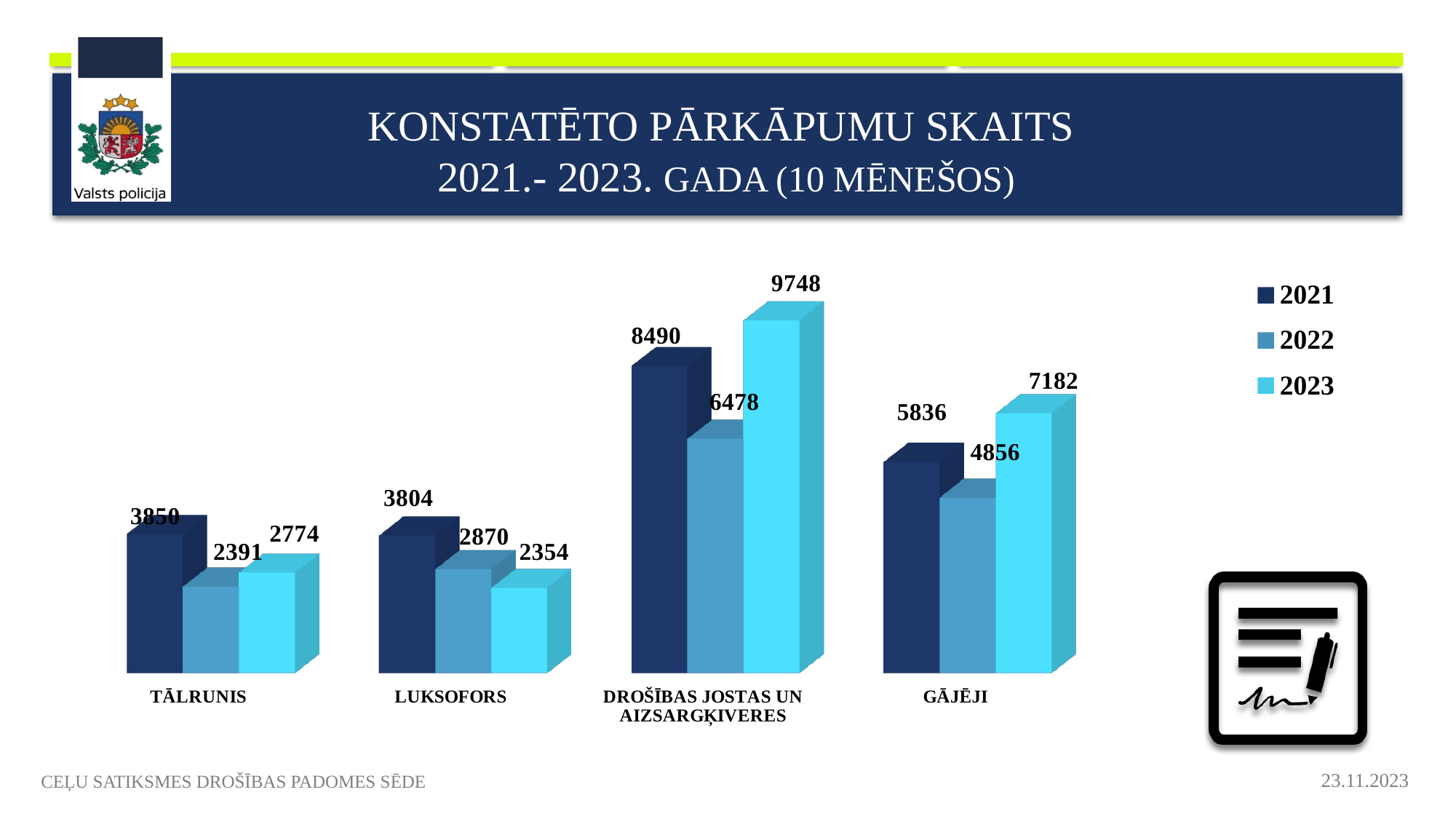
Which is larger for LUKSOFORS: the 2021 value or the 2023 value? 2021 How many series does the legend list? 3 What is the difference between the 2023 and 2021 values for DROŠĪBAS JOSTAS UN AIZSARGĶIVERES? 1258 What is the value for TĀLRUNIS in 2021? 3850 How many categories are shown on the x axis? 4 Do the values for GĀJĒJI rise or fall from 2022 to 2023? rise What kind of chart is shown on the slide? bar chart Which category has the highest value in 2023? DROŠĪBAS JOSTAS UN AIZSARGĶIVERES What is the value for LUKSOFORS in 2022? 2870 Which series is shown in the lightest blue colour in the legend? 2023 What is the value for GĀJĒJI in 2023? 7182 Which category has the lowest value in 2022? TĀLRUNIS